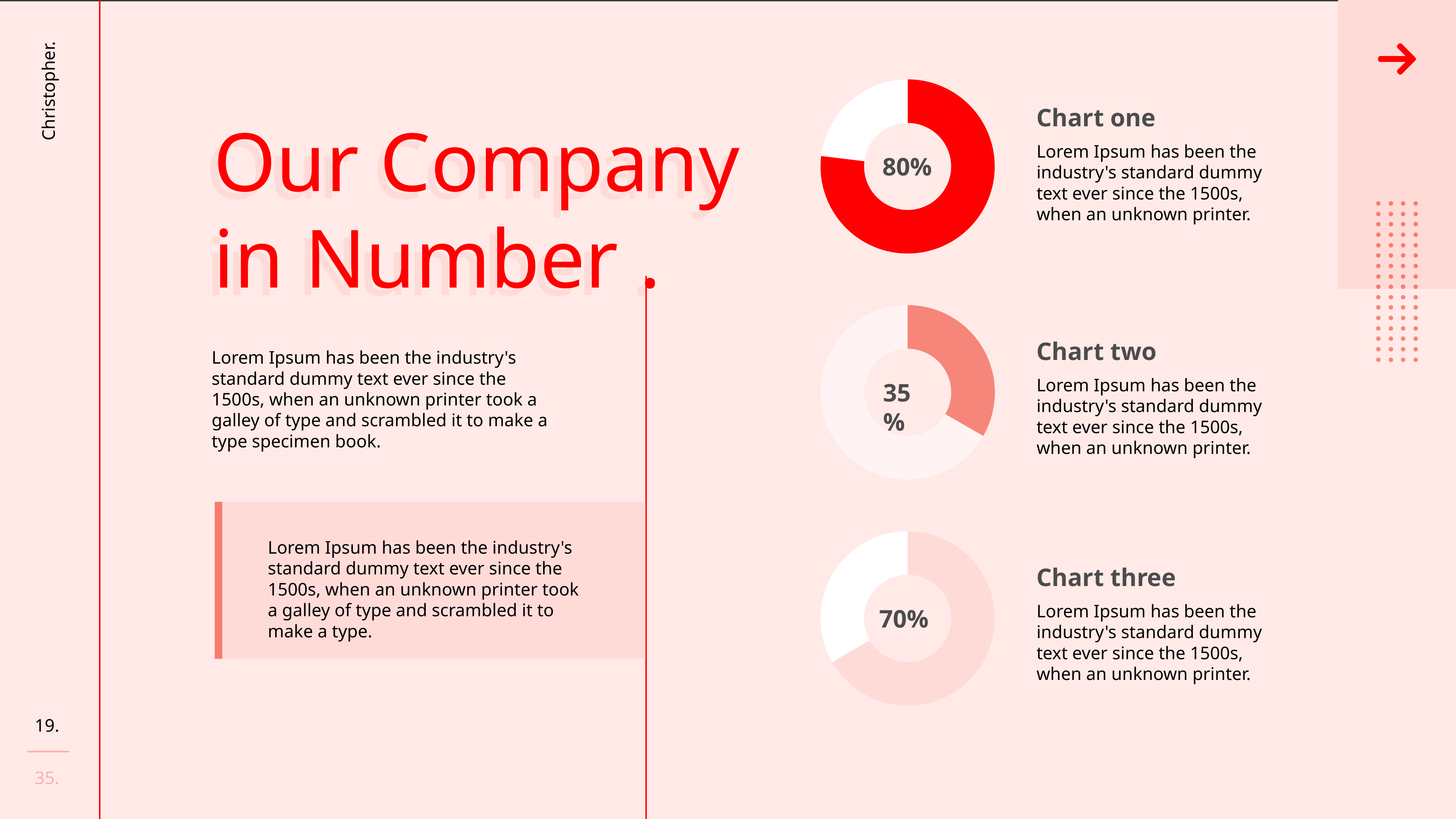
What percentage is shown in the centre of Chart two? 35% What is the difference between the percentage in Chart one and the percentage in Chart three? 10% What is the difference between the percentage in Chart one and the percentage in Chart two? 45% Which of the three charts shows the lowest percentage? Chart two What kind of chart is Chart one? Doughnut chart What percentage is shown in the centre of Chart three? 70% How many doughnut charts are shown on the slide? 3 What percentage is shown in the centre of Chart one? 80% Which shows a larger percentage, Chart two or Chart three? Chart three Which of the three charts shows the highest percentage? Chart one What is the title of the slide? Our Company in Number.